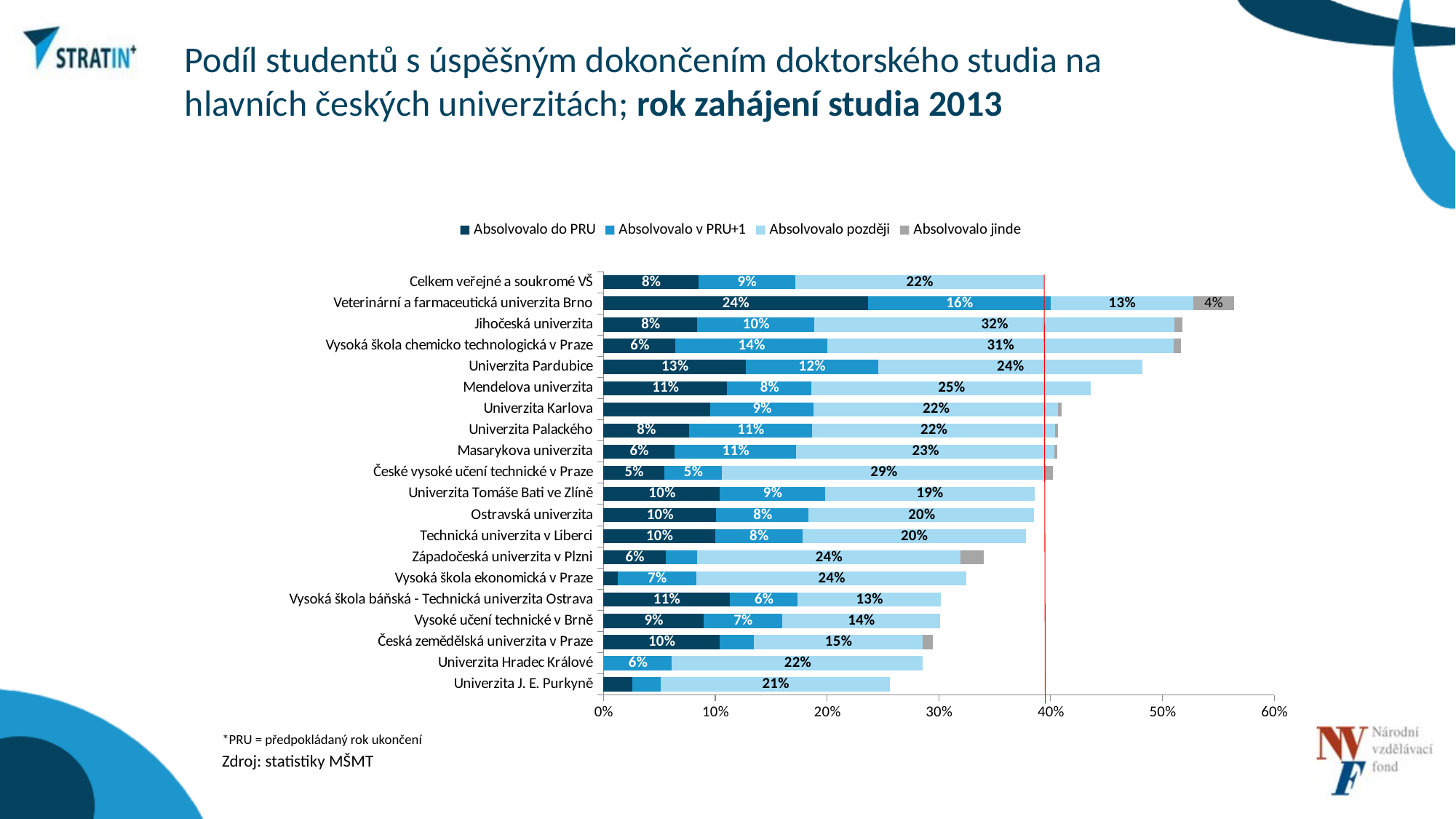
Which is larger: the 'Absolvovalo později' value for Jihočeská univerzita or for Univerzita Pardubice? Jihočeská univerzita What is the 'Absolvovalo později' value for Jihočeská univerzita? 32% Is the total bar length for Univerzita J. E. Purkyně greater or less than 30%? less How many series does the legend list? 4 What type of chart is shown on the slide? Stacked bar chart What is the 'Absolvovalo do PRU' value for Veterinární a farmaceutická univerzita Brno? 24% What is the difference between the 'Absolvovalo do PRU' values of Veterinární a farmaceutická univerzita Brno and Jihočeská univerzita? 16 percentage points How many universities/categories are plotted on the chart? 20 Which university has the highest 'Absolvovalo do PRU' value? Veterinární a farmaceutická univerzita Brno What is the 'Absolvovalo jinde' value for Veterinární a farmaceutická univerzita Brno? 4% Is the total bar length for Veterinární a farmaceutická univerzita Brno greater or less than 50%? greater What is the 'Absolvovalo v PRU+1' value for Vysoká škola chemicko technologická v Praze? 14%